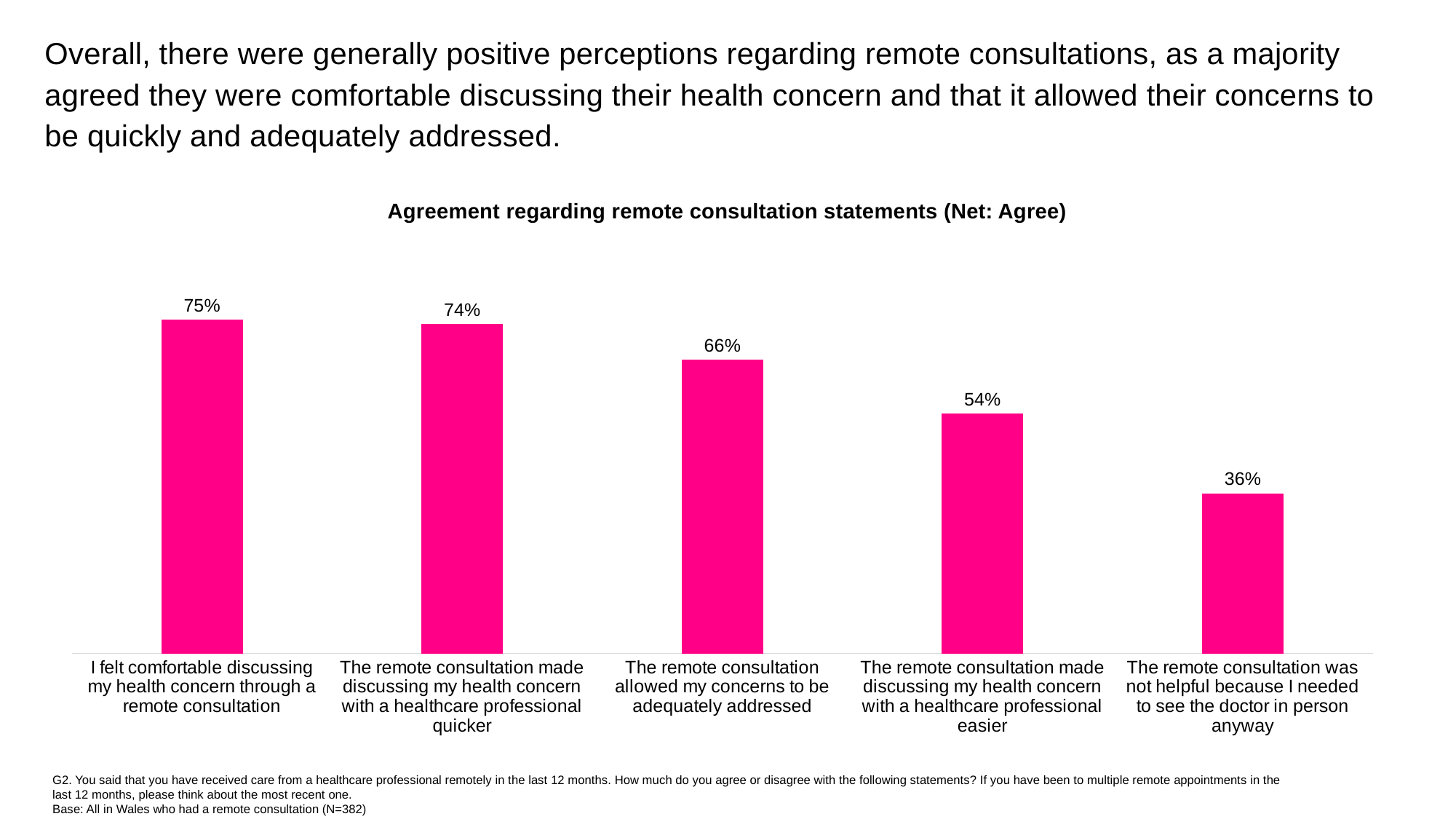
How many statements are shown in the chart? 5 Which statement has the lowest level of agreement? The remote consultation was not helpful because I needed to see the doctor in person anyway What percentage agreed with the statement 'I felt comfortable discussing my health concern through a remote consultation'? 75% What is the difference between the agreement for 'made discussing my health concern with a healthcare professional quicker' and 'made discussing my health concern with a healthcare professional easier'? 20% Do the values rise or fall from left to right across the chart? Fall Which is larger: the value for 'allowed my concerns to be adequately addressed' or the value for 'not helpful because I needed to see the doctor in person anyway'? The remote consultation allowed my concerns to be adequately addressed What percentage agreed that the remote consultation was not helpful because they needed to see the doctor in person anyway? 36% What is the value for 'The remote consultation allowed my concerns to be adequately addressed'? 66% What is the value for 'The remote consultation made discussing my health concern with a healthcare professional easier'? 54% Which statement has the highest level of agreement? I felt comfortable discussing my health concern through a remote consultation What is the title of the chart? Agreement regarding remote consultation statements (Net: Agree) What type of chart is shown on the slide? Bar chart